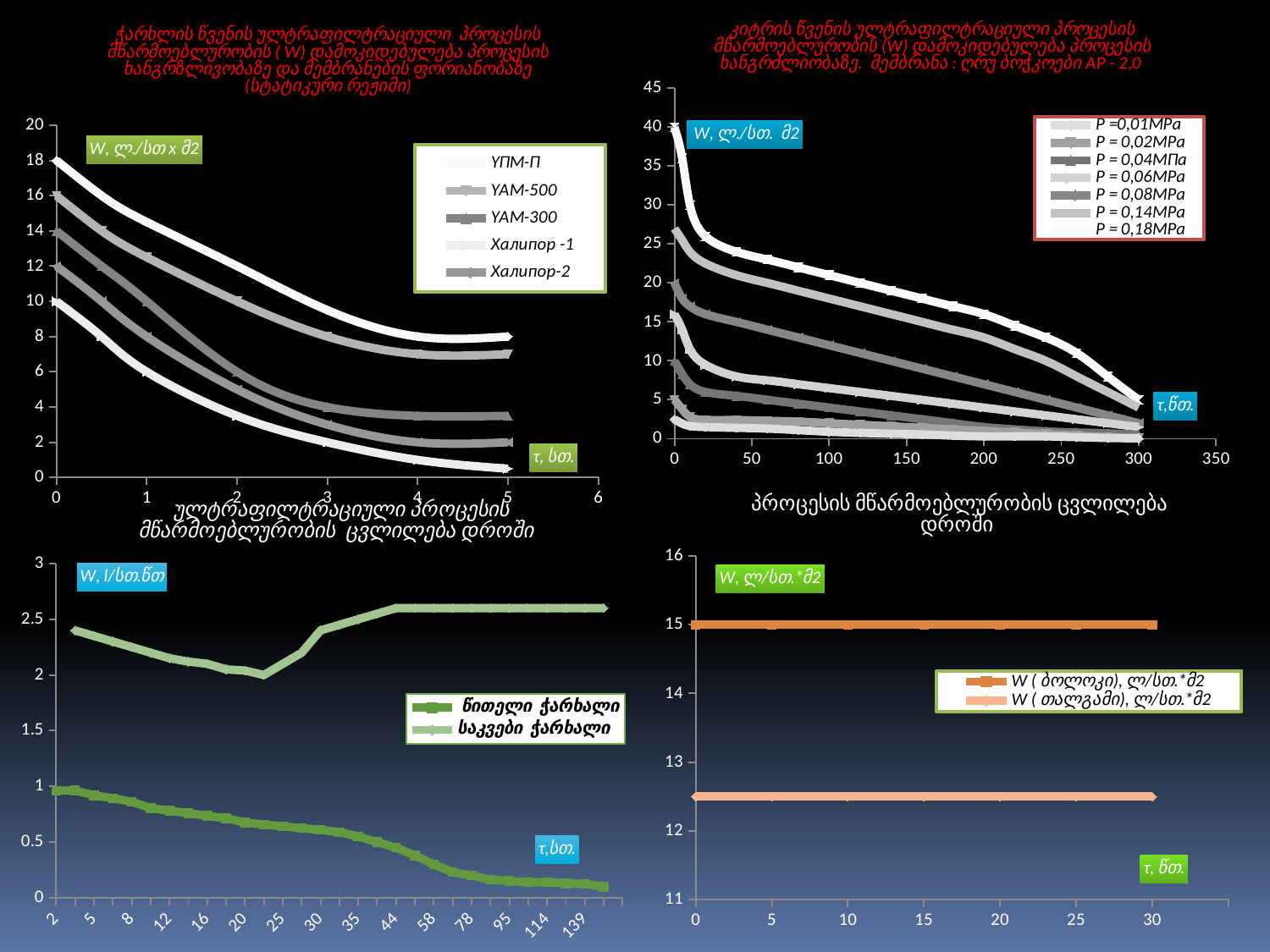
On the top-right chart, how many series does the legend list? 7 On the top-right chart, is the value for P = 0,01MPa at τ = 0 greater or less than 35? less On the bottom-left chart, which series has the higher values, წითელი ჭარხალი or საკვები ჭარხალი? საკვები ჭარხალი On the bottom-right chart, what is the value of the W (ბოლოკი) series? 15 On the bottom-right chart, how many series does the legend list? 2 On the bottom-left chart, is the value for წითელი ჭარხალი at category 139 greater or less than 0.5? less What kind of chart is the bottom-right chart? line chart On the top-left chart, how many series does the legend list? 5 On the top-left chart, do the values rise or fall as τ increases along the x axis? fall